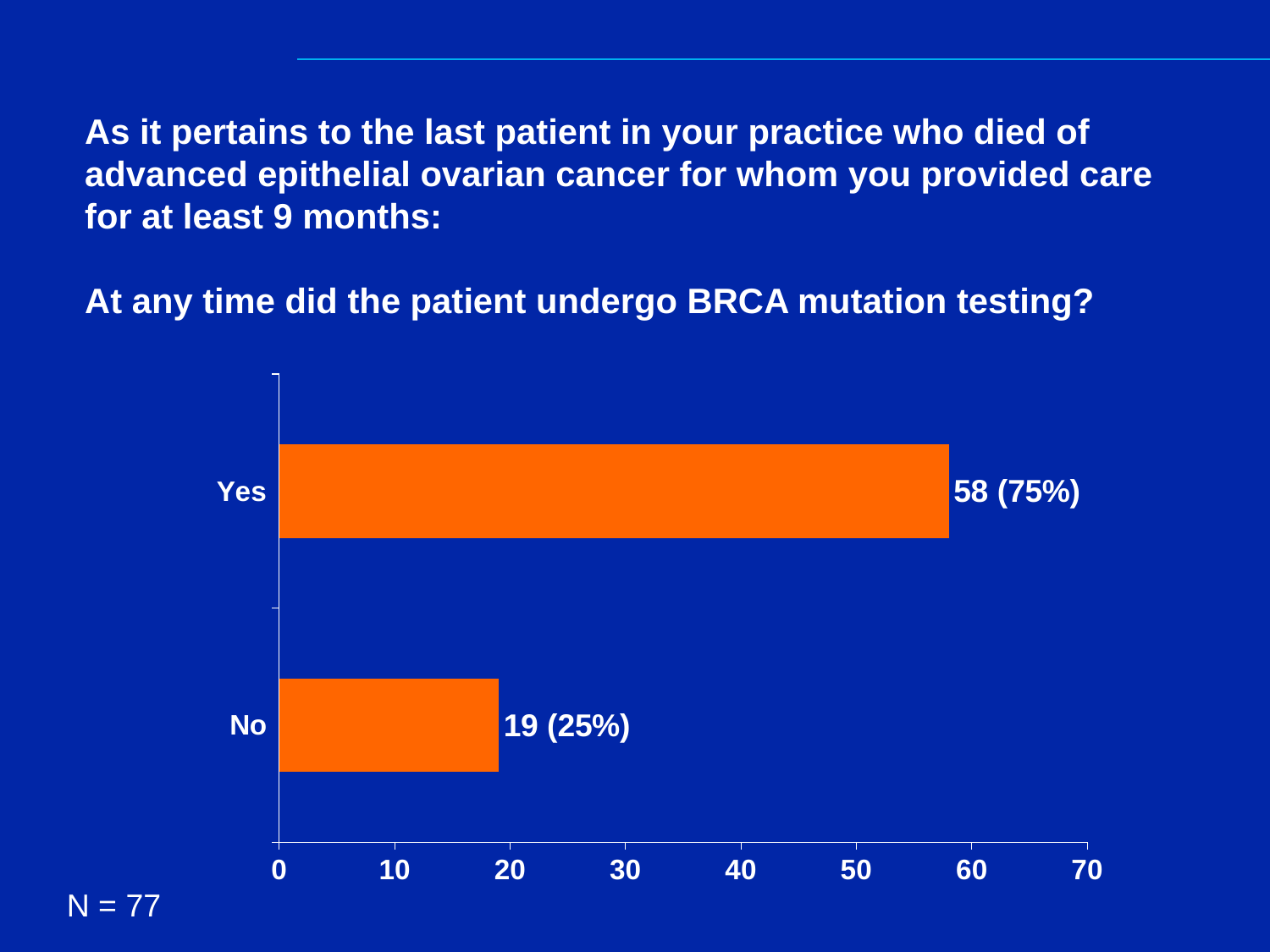
Which category has the lowest value? No Which category has the highest value? Yes How many categories are shown in the chart? 2 Which is larger, the value for "Yes" or the value for "No"? Yes Is the value for "No" greater or less than 20? less What is the difference in count between the "Yes" and "No" bars? 39 What kind of chart is shown on the slide? Bar chart Is the value for "Yes" greater or less than 50? greater What is the value shown for the "Yes" bar? 58 (75%) What is the value shown for the "No" bar? 19 (25%) What is the maximum value shown on the x axis? 70 What is the total number of respondents (N) shown on the slide? 77